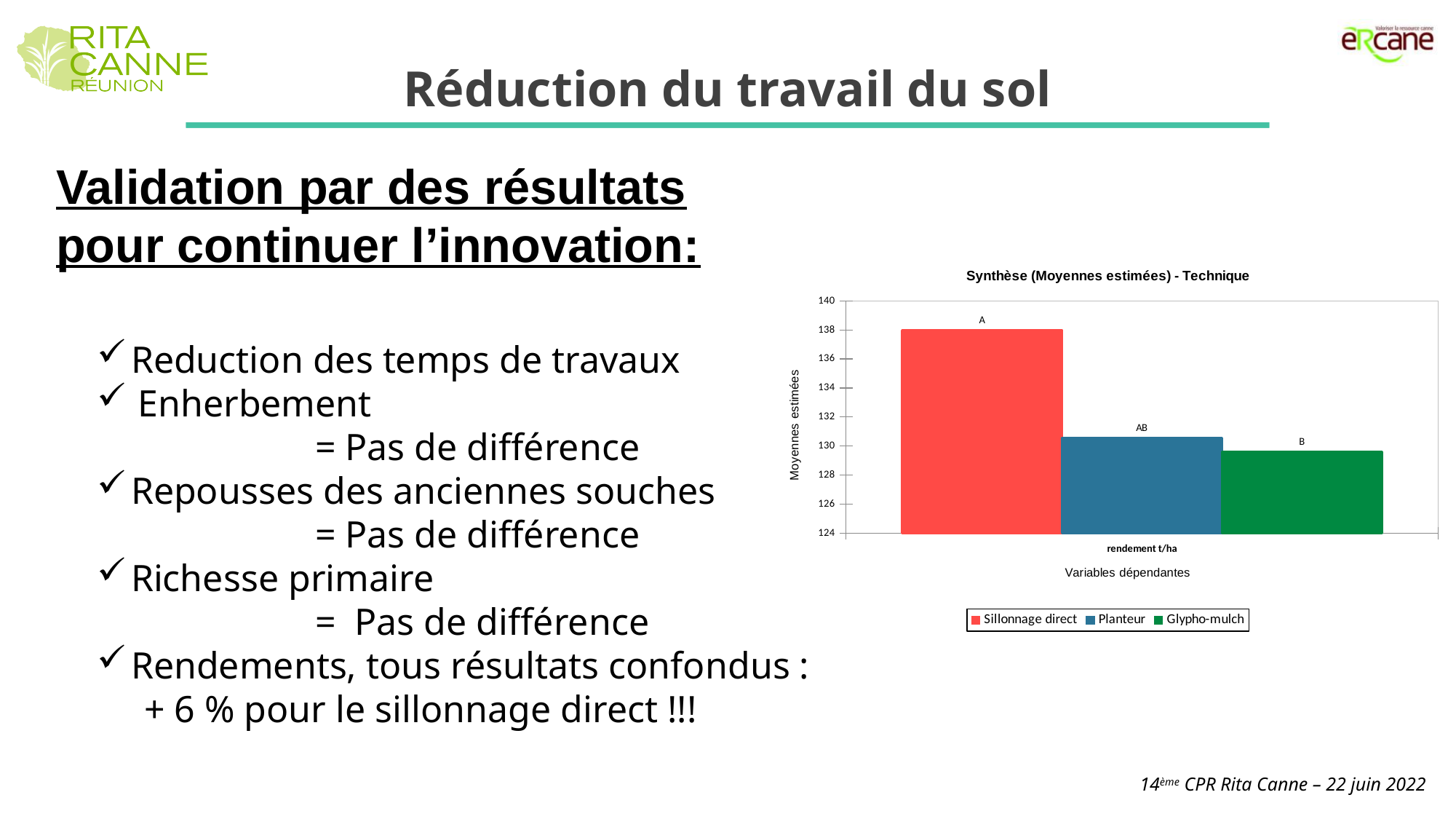
How many categories are shown on the x axis of the chart? 1 Which series has the highest bar in the chart? Sillonnage direct How many series does the chart legend list? 3 What kind of chart is shown on the slide? bar chart What is the title of the chart? Synthèse (Moyennes estimées) - Technique What is the label on the y axis of the chart? Moyennes estimées Is the value for Planteur greater or less than 134? less Is the value for Sillonnage direct greater or less than 136? greater Is the value for Glypho-mulch greater or less than 132? less Which is larger, the value for Sillonnage direct or the value for Planteur? Sillonnage direct What letter is printed above the Planteur bar? AB